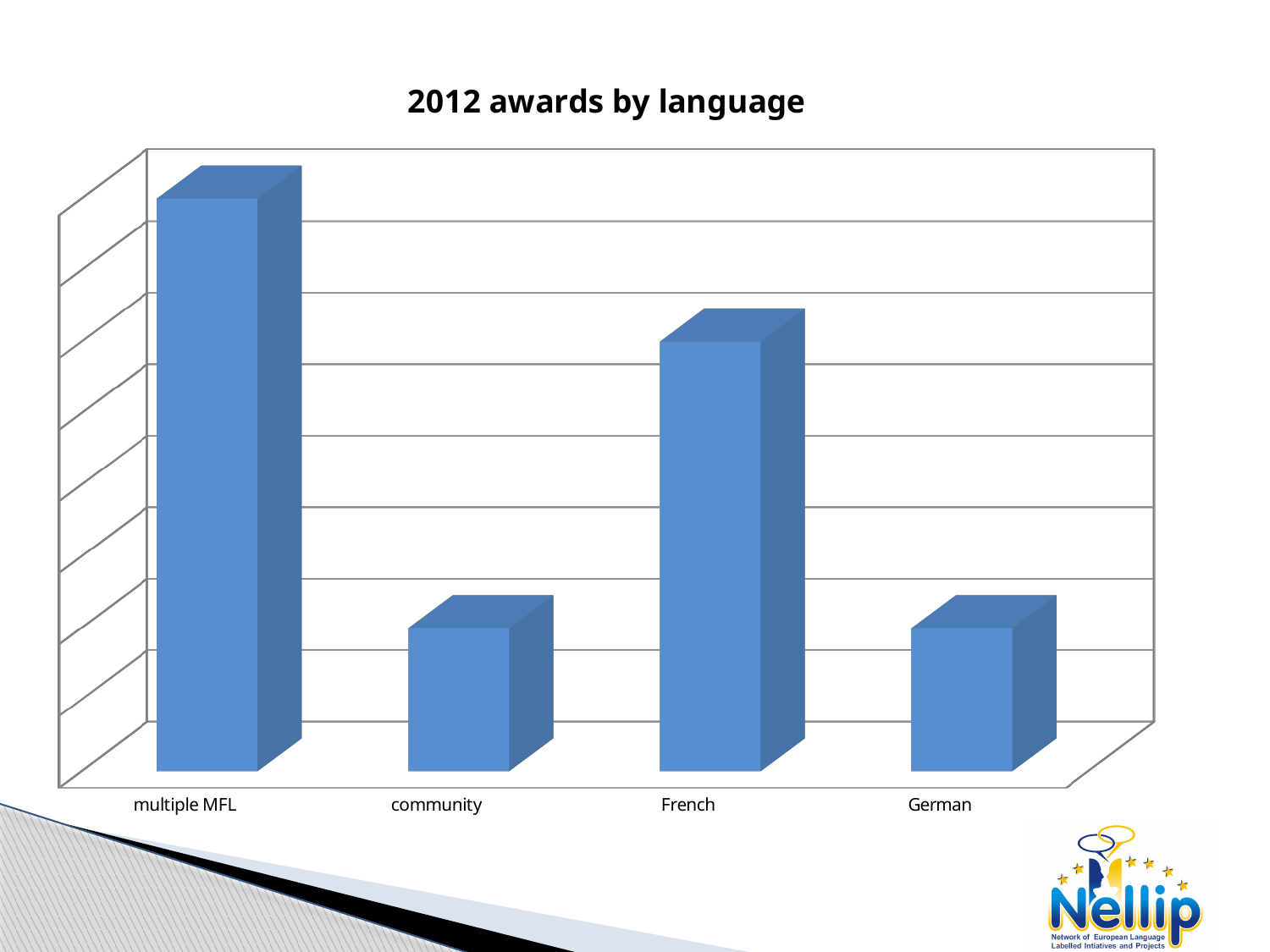
What kind of chart is shown on the slide? bar chart What is the title of the chart? 2012 awards by language Which is larger, the value for German or the value for French? French Which is larger, the value for multiple MFL or the value for German? multiple MFL Which is larger, the value for multiple MFL or the value for French? multiple MFL Which category has the highest value in the chart? multiple MFL Which category is shown second from the left on the x axis? community How many categories are shown on the x axis of the chart? 4